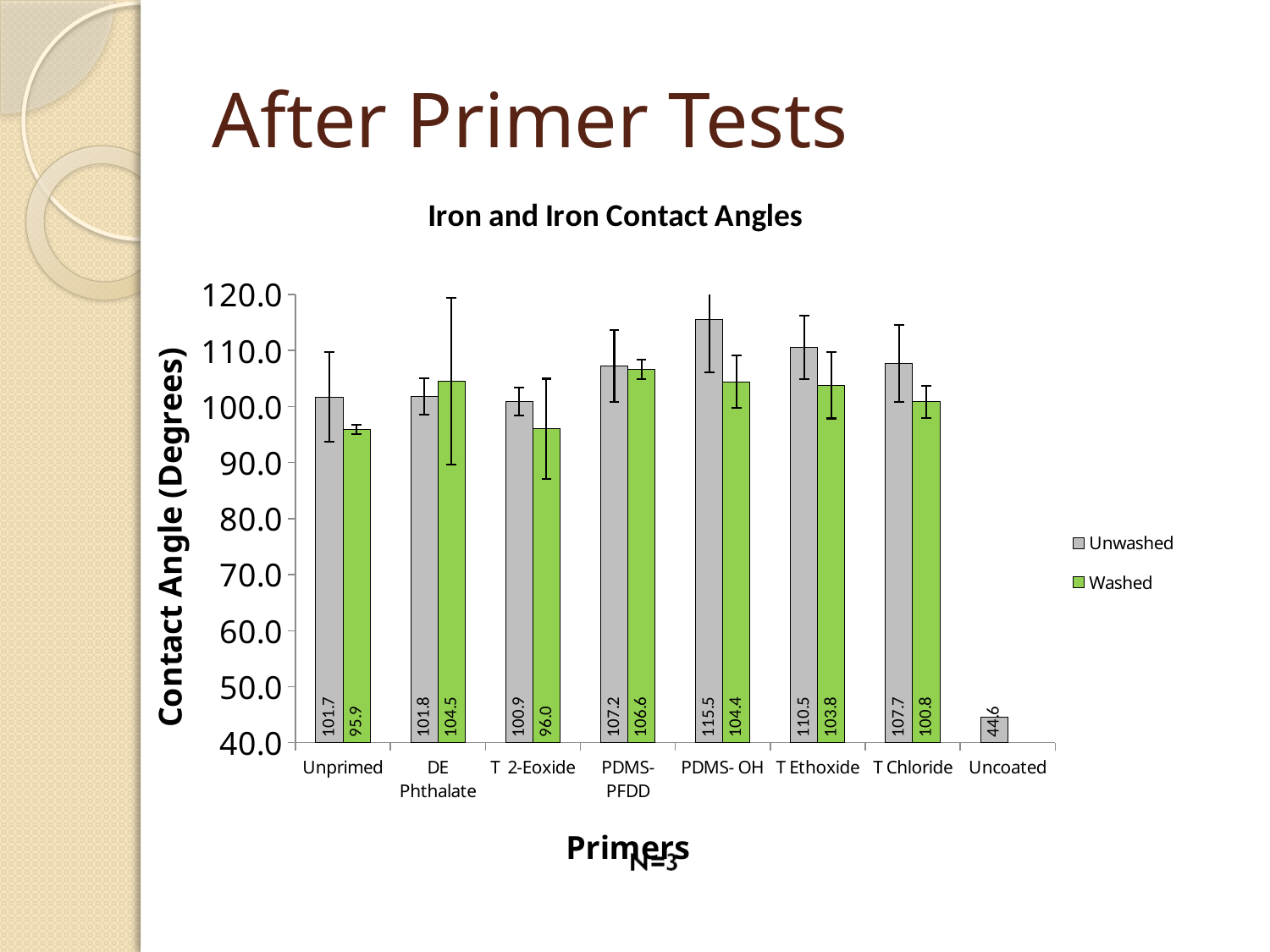
What is the Unwashed contact angle for Uncoated? 44.6 Which category has the lowest Unwashed contact angle? Uncoated Which is larger for T Ethoxide, the Unwashed or the Washed contact angle? Unwashed What kind of chart is shown on the slide? Bar chart Which primer has the highest Washed contact angle? PDMS-PFDD How many series does the legend list? 2 How many primer categories are shown on the x axis? 8 What is the Washed contact angle for DE Phthalate? 104.5 What is the Unwashed contact angle for PDMS- OH? 115.5 Which primer has the highest Unwashed contact angle? PDMS- OH What is the title of the chart? Iron and Iron Contact Angles What is the difference between the Unwashed and Washed contact angles for PDMS- OH? 11.1